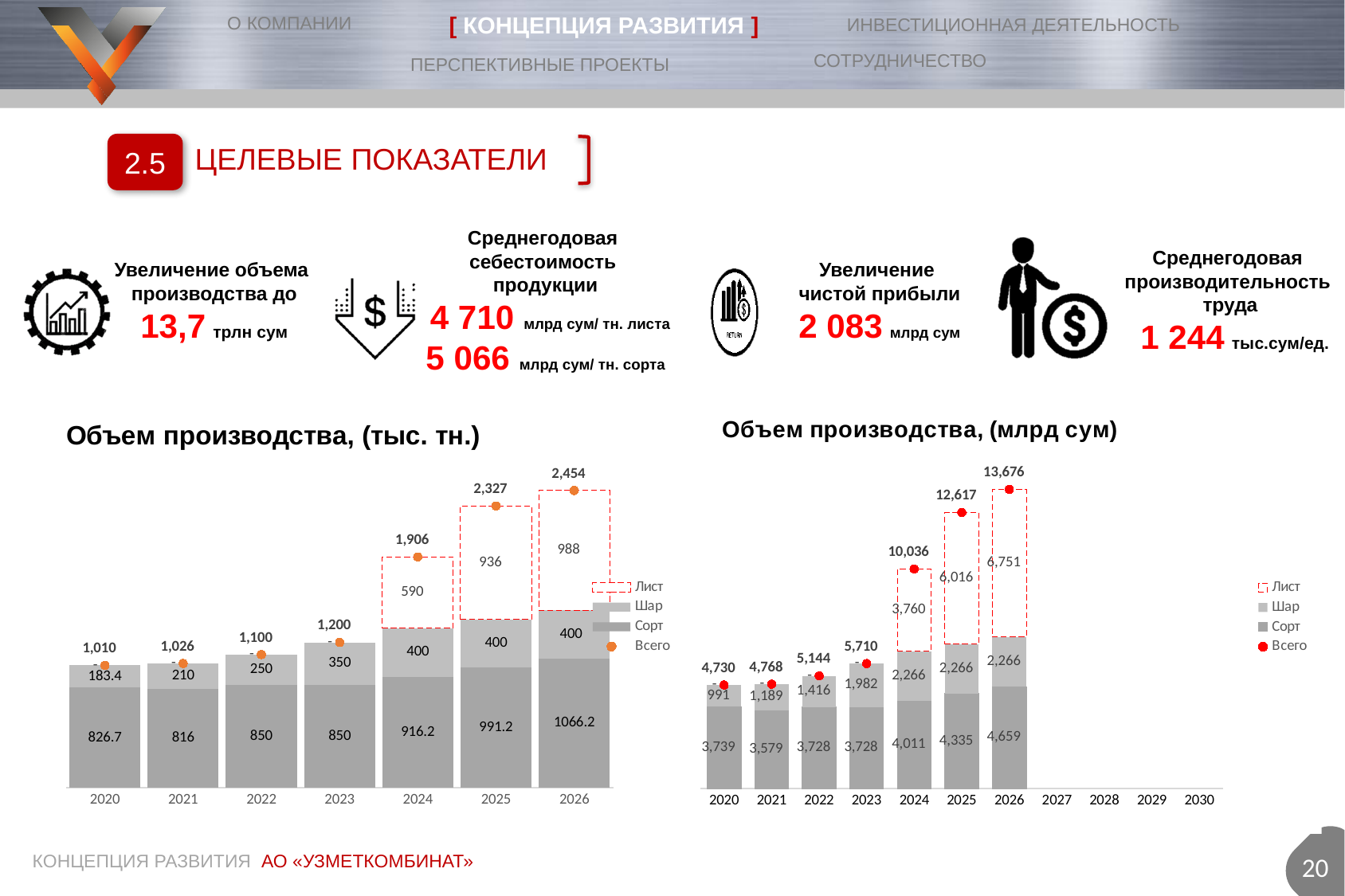
In the chart 'Объем производства, (млрд сум)', what is the Всего value for 2026? 13,676 In the chart 'Объем производства, (млрд сум)', what is the difference between the Всего values for 2025 and 2024? 2,581 In the chart 'Объем производства, (тыс. тн.)', how many series does the legend list? 4 In the chart 'Объем производства, (млрд сум)', what is the Сорт value for 2021? 3,579 In the chart 'Объем производства, (тыс. тн.)', what is the Всего value for 2025? 2,327 In the chart 'Объем производства, (тыс. тн.)', what is the difference between the Шар values for 2023 and 2022? 100 What type of chart is 'Объем производства, (млрд сум)'? Stacked bar chart In the chart 'Объем производства, (млрд сум)', which year has the lowest Всего value? 2020 In the chart 'Объем производства, (тыс. тн.)', what is the Лист value for 2024? 590 In the chart 'Объем производства, (тыс. тн.)', which year has the highest Всего value? 2026 In the chart 'Объем производства, (тыс. тн.)', what is the Сорт value for 2026? 1066.2 In the chart 'Объем производства, (млрд сум)', is the Лист value for 2025 larger or smaller than the Лист value for 2026? smaller